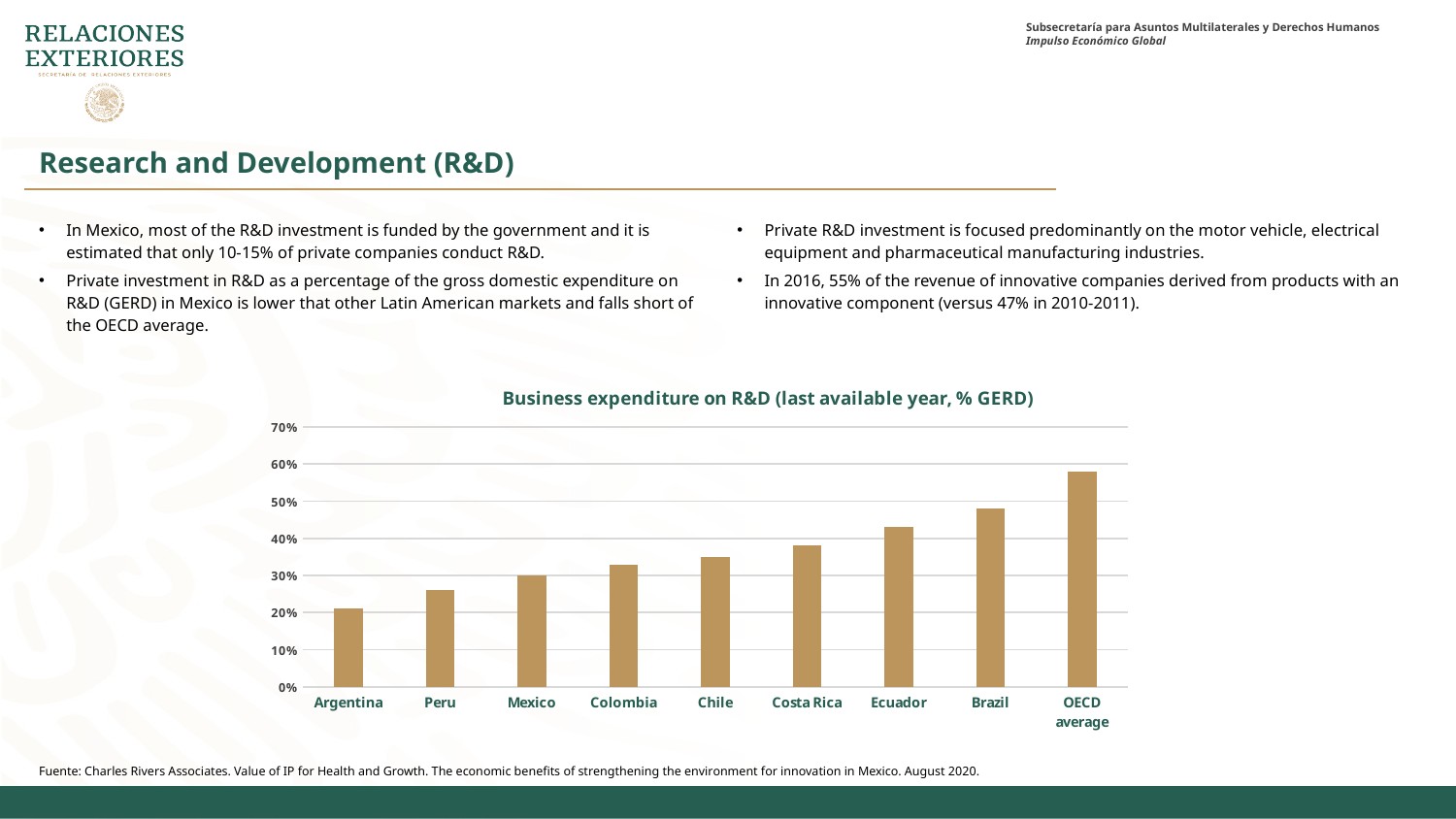
Is the value for Ecuador greater or less than 40%? greater Which has a larger value, Brazil or Chile? Brazil Is the value for OECD average greater or less than 50%? greater What kind of chart is shown on the slide? bar chart Do the values rise or fall moving from left to right along the x axis? rise Which category has the highest value in the chart? OECD average Is the value for Argentina greater or less than 30%? less How many categories are shown on the x axis of the chart? 9 Which has a larger value, Mexico or Costa Rica? Costa Rica What is the title of the chart? Business expenditure on R&D (last available year, % GERD) Which category has the lowest value in the chart? Argentina